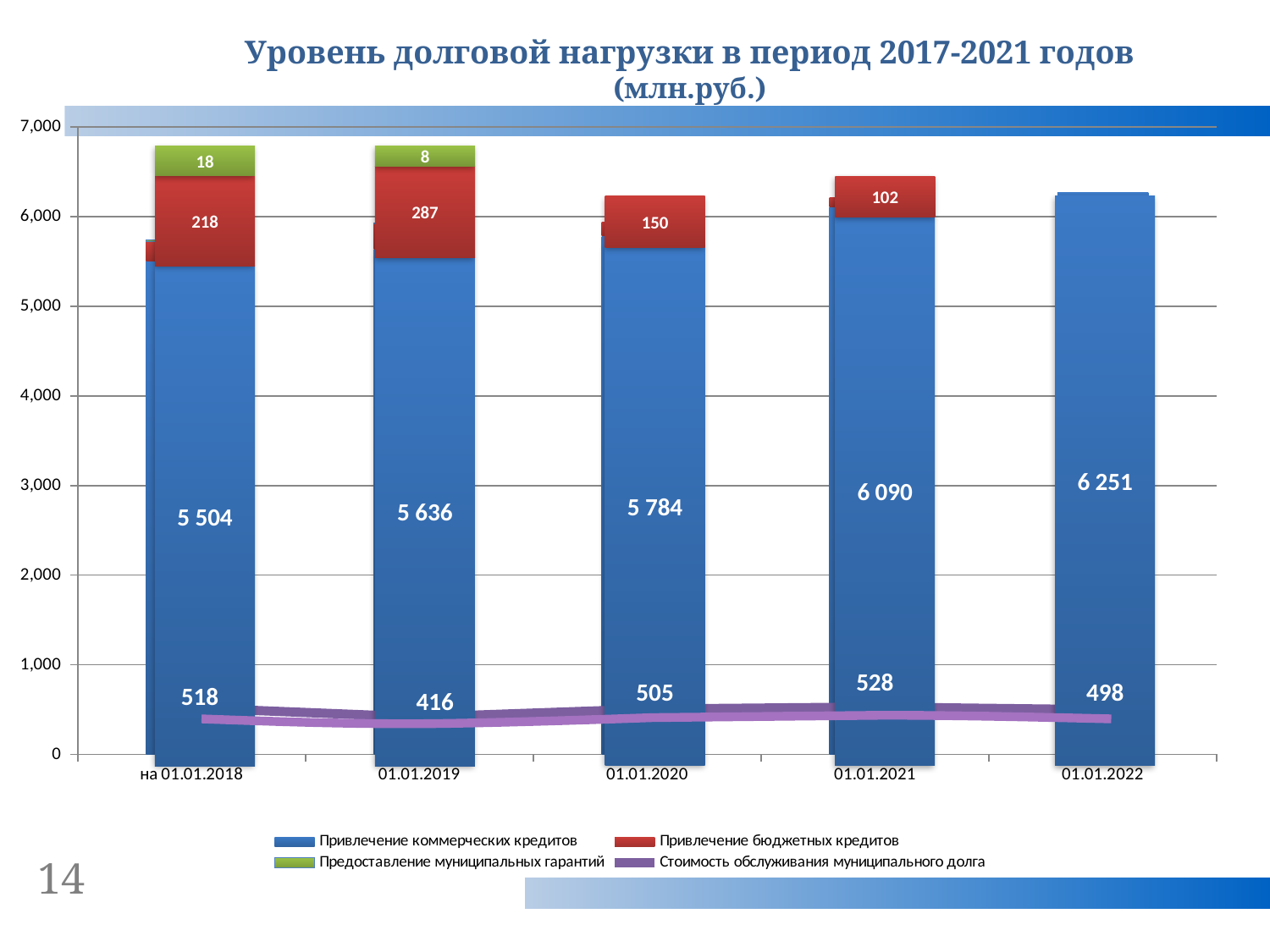
What type of chart is shown on the slide? Stacked bar chart with a line What is the value of 'Привлечение бюджетных кредитов' for 01.01.2019? 287 Which is larger: 'Привлечение бюджетных кредитов' on на 01.01.2018 or on 01.01.2020? на 01.01.2018 Which date has the highest value for 'Привлечение коммерческих кредитов'? 01.01.2022 Does 'Привлечение коммерческих кредитов' rise or fall from на 01.01.2018 to 01.01.2022? Rise What is the value of 'Предоставление муниципальных гарантий' for на 01.01.2018? 18 How many dates are shown on the x axis? 5 What is the value of 'Стоимость обслуживания муниципального долга' for 01.01.2021? 528 What is the difference between 'Привлечение коммерческих кредитов' on 01.01.2022 and on 01.01.2021? 161 Which date has the lowest value for 'Стоимость обслуживания муниципального долга'? 01.01.2019 What is the value of 'Привлечение коммерческих кредитов' for 01.01.2020? 5 784 How many series does the legend list? 4